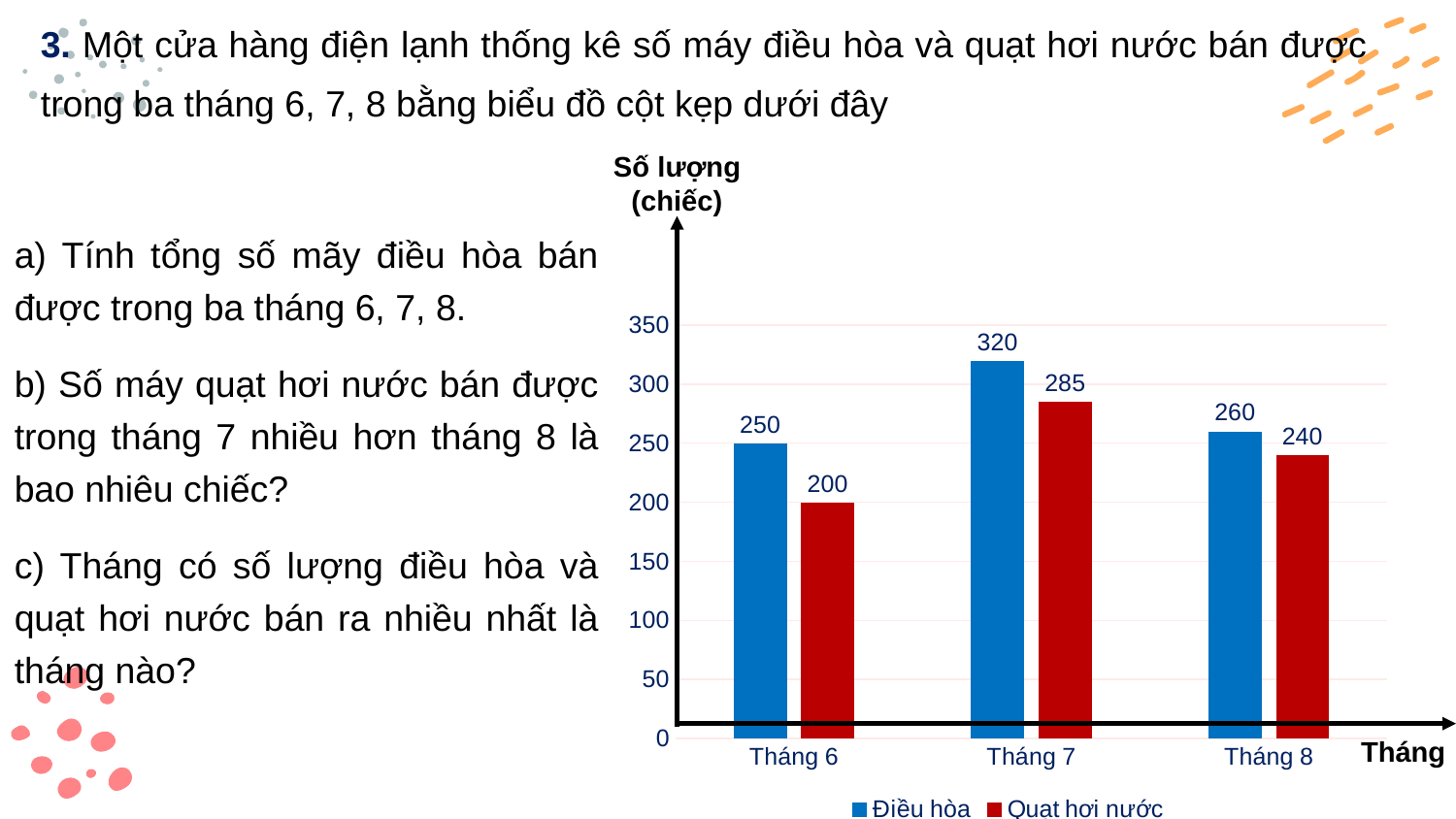
What is the value for Quạt hơi nước in Tháng 8? 240 What is the difference between Quạt hơi nước in Tháng 7 and Tháng 8? 45 What kind of chart is shown? bar chart How many months are shown on the x axis? 3 Which is larger: Điều hòa in Tháng 8 or Quạt hơi nước in Tháng 7? Quạt hơi nước in Tháng 7 What is the value for Quạt hơi nước in Tháng 6? 200 How many series does the legend list? 2 What is the value for Điều hòa in Tháng 7? 320 Which month has the highest value for Điều hòa? Tháng 7 What is the total of Điều hòa across Tháng 6, Tháng 7 and Tháng 8? 830 Which month has the lowest value for Quạt hơi nước? Tháng 6 What is the label of the vertical axis? Số lượng (chiếc)